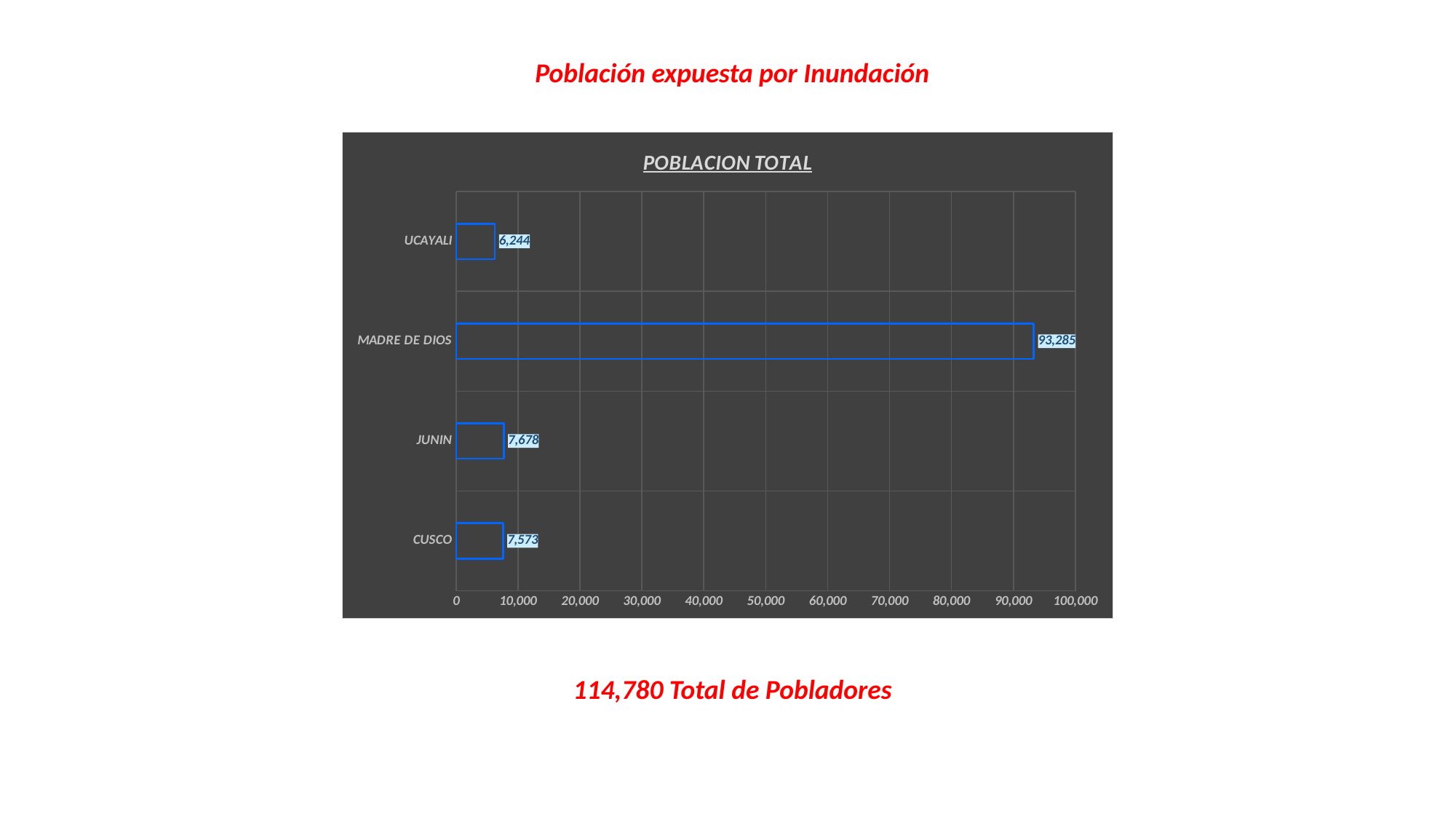
Which is larger, the value for JUNIN or the value for CUSCO? JUNIN What kind of chart is shown on the slide? Bar chart What is the value for MADRE DE DIOS? 93,285 What is the difference between the values for JUNIN and CUSCO? 105 Which category has the lowest value? UCAYALI What is the difference between the values for MADRE DE DIOS and UCAYALI? 87,041 What is the value for UCAYALI? 6,244 How many categories are shown in the chart? 4 What is the value for JUNIN? 7,678 Is the value for MADRE DE DIOS greater or less than 90,000? greater What is the value for CUSCO? 7,573 Which category has the highest value? MADRE DE DIOS